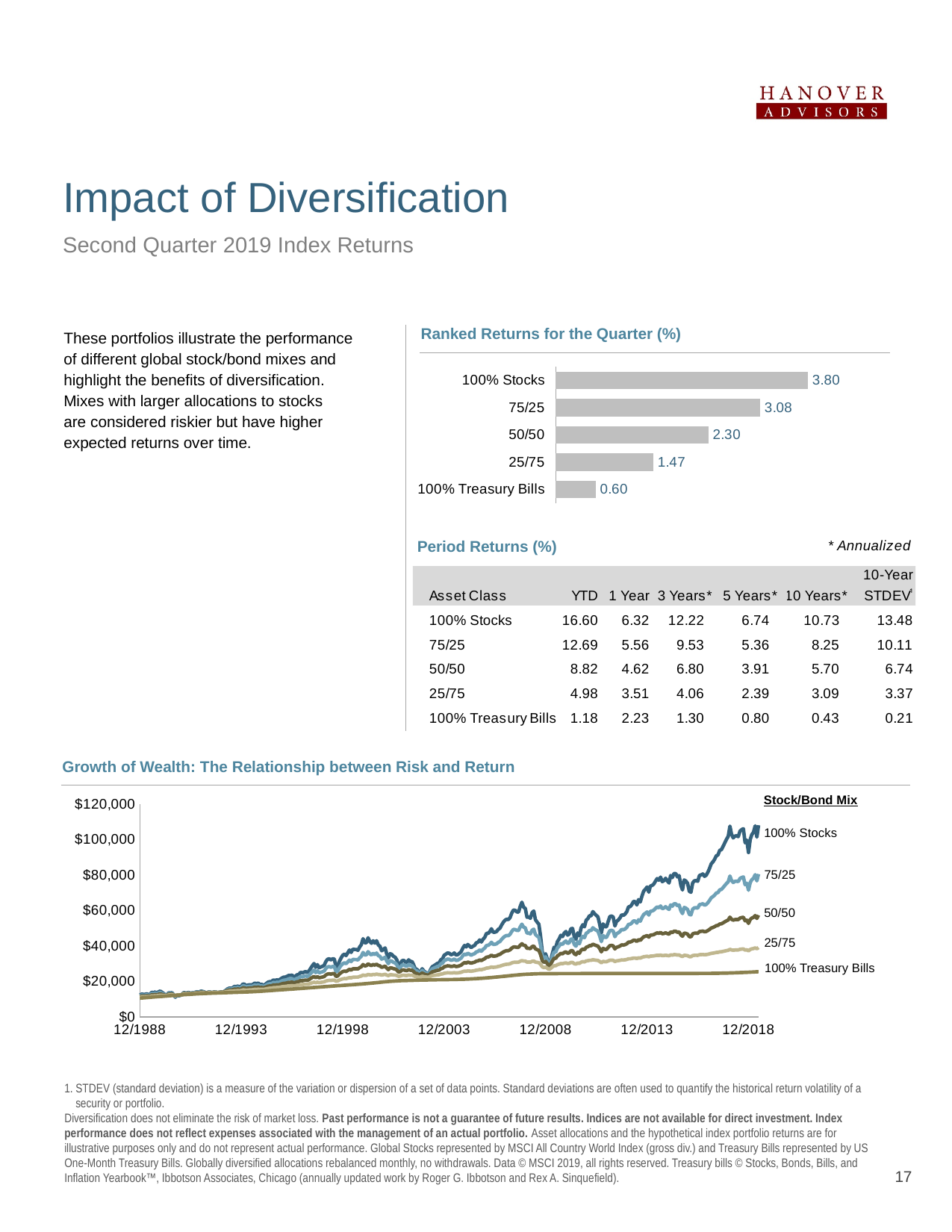
In the Ranked Returns for the Quarter chart, which category has the lowest value? 100% Treasury Bills How many categories are shown in the Ranked Returns for the Quarter chart? 5 In the Growth of Wealth chart, is the value for 100% Stocks at 12/2018 greater or less than $80,000? greater In the Ranked Returns for the Quarter chart, what is the value for 50/50? 2.30 How many series are plotted in the Growth of Wealth chart? 5 In the Ranked Returns for the Quarter chart, which is larger, the value for 50/50 or the value for 25/75? 50/50 In the Ranked Returns for the Quarter chart, which category has the highest value? 100% Stocks In the Ranked Returns for the Quarter chart, what is the difference between the values for 75/25 and 25/75? 1.61 What kind of chart is the Ranked Returns for the Quarter chart? Bar chart In the Ranked Returns for the Quarter chart, what is the value for 100% Treasury Bills? 0.60 In the Ranked Returns for the Quarter chart, what is the value for 100% Stocks? 3.80 What kind of chart is the Growth of Wealth chart? Line chart